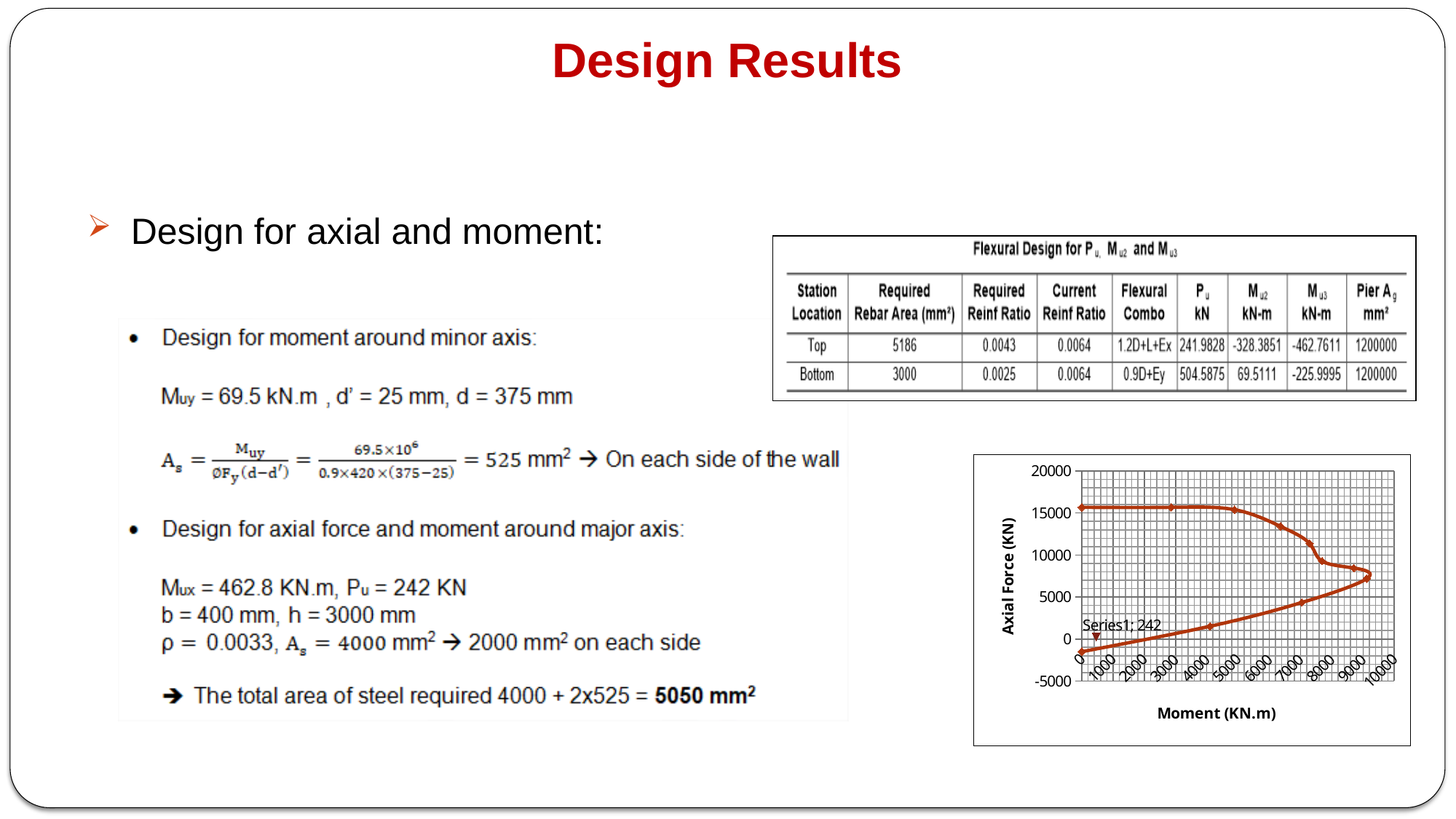
Is the maximum axial force reached by the interaction curve greater or less than 15000? greater What is the title of the vertical axis of the chart? Axial Force (KN) Is the axial force of the labeled Series1 point greater or less than 5000? less What is the lowest tick value shown on the vertical axis of the chart? -5000 What is the highest tick value shown on the horizontal axis of the chart? 10000 What is the highest tick value shown on the vertical axis of the chart? 20000 What kind of chart is shown on the slide? line chart What is the title of the horizontal axis of the chart? Moment (KN.m) Is the moment of the labeled Series1 point greater or less than 1000? less What axial force value is shown in the data label for the Series1 point on the chart? 242